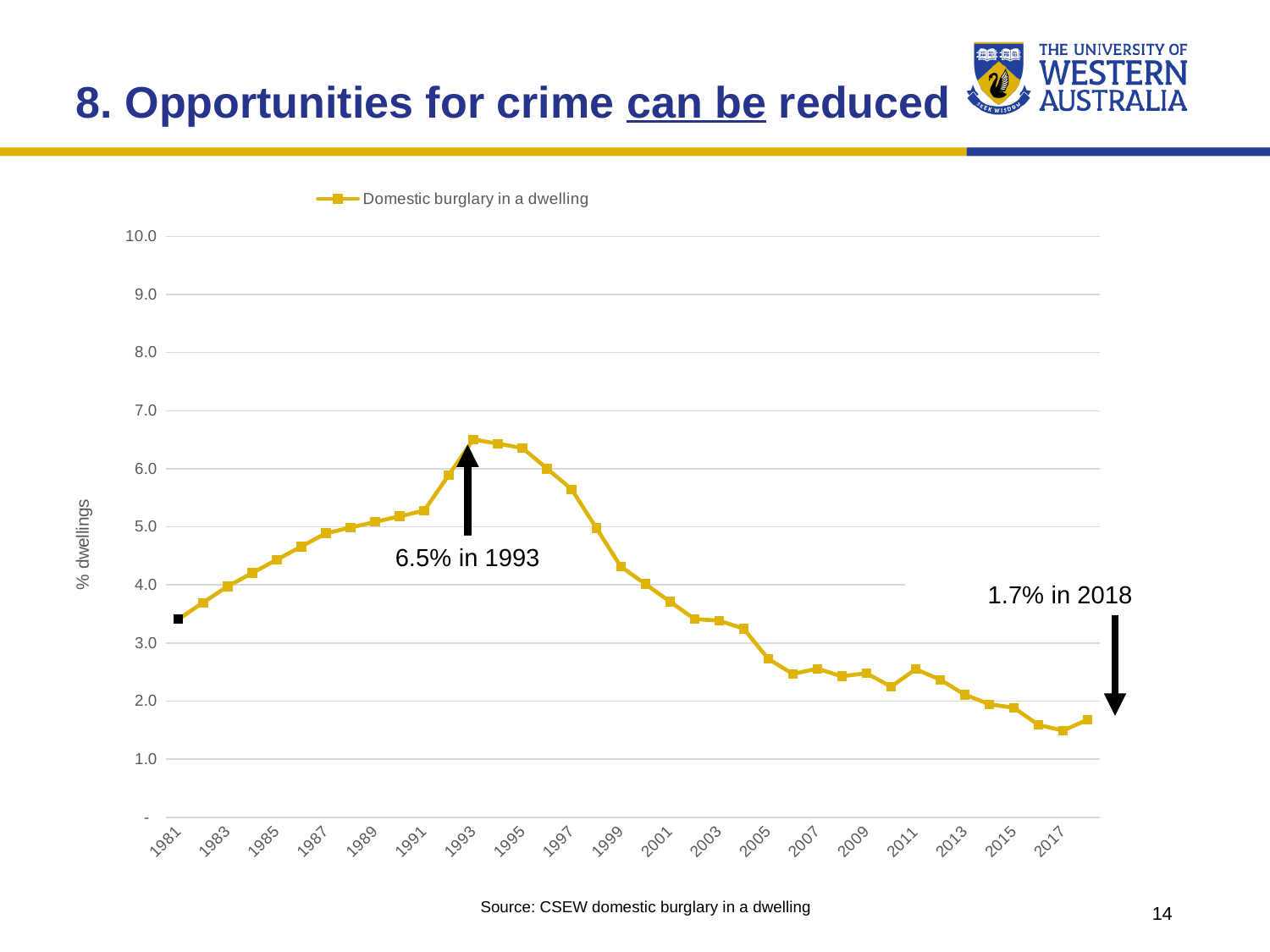
What is the label on the vertical axis? % dwellings What kind of chart is shown on the slide? line chart Is the value for 1981 greater or less than 4.0? less What is the difference between the 1993 value and the 2018 value? 4.8 percentage points Which year has the larger value, 1993 or 2018? 1993 Is the value for 2005 greater or less than 3.0? less What is the value of domestic burglary in a dwelling in 2018? 1.7% What is the value of domestic burglary in a dwelling in 1993? 6.5% In which year does the domestic burglary line reach its highest value? 1993 Is the value for 1997 greater or less than 5.0? greater Does the line rise or fall between 1993 and 2018? fall How many series does the legend list? 1